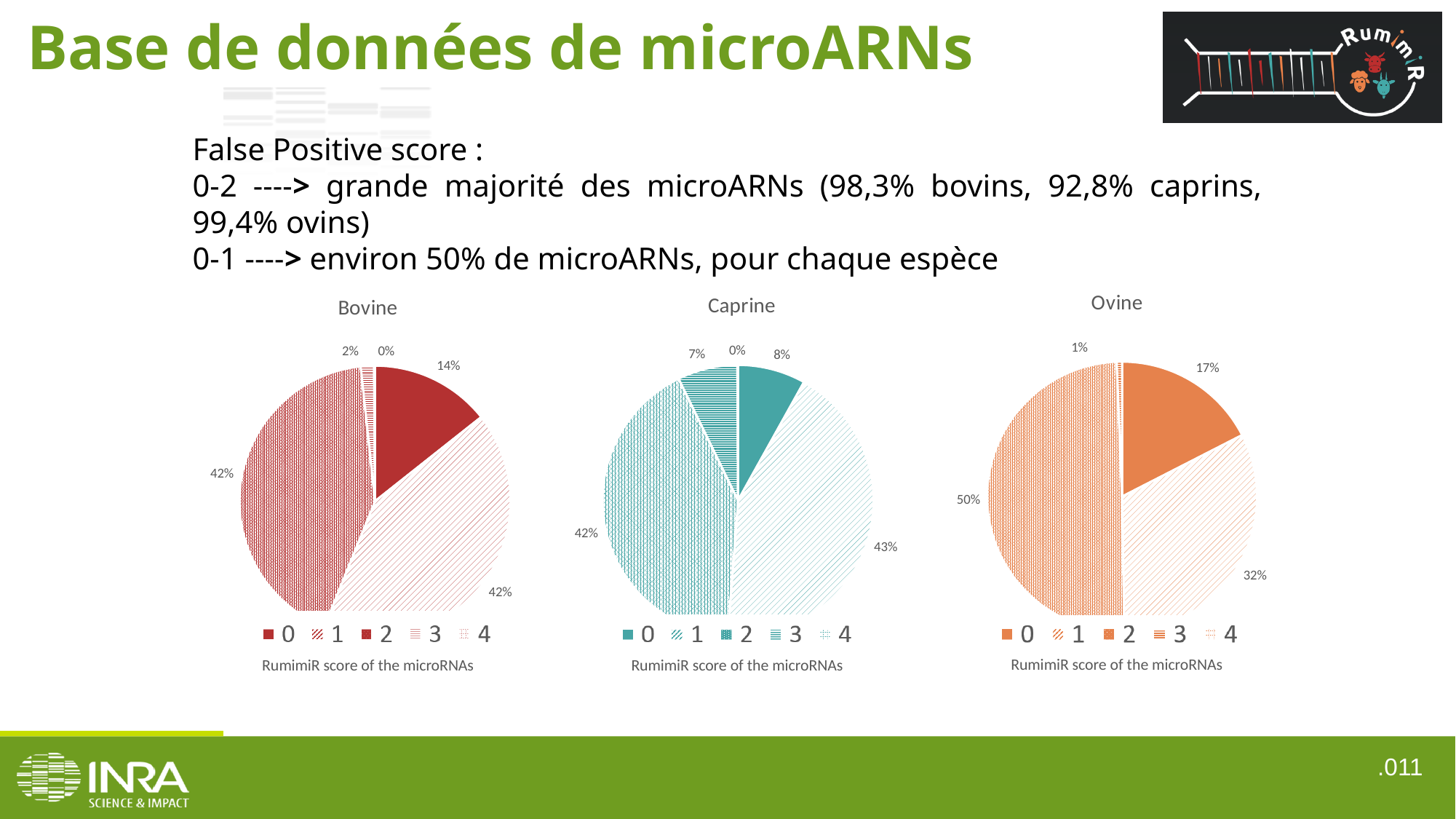
In the Bovine pie chart, what share of microRNAs has a RumimiR score of 0? 14% In the Bovine pie chart, which RumimiR score has the smallest share? 4 In the Caprine pie chart, what share of microRNAs has a RumimiR score of 1? 43% How many entries does the legend of the Bovine pie chart list? 5 What type of chart is used for the Caprine data? pie chart In the Caprine pie chart, which RumimiR score has the largest share? 1 In the Caprine pie chart, what share of microRNAs has a RumimiR score of 3? 7% In the Ovine pie chart, what is the difference between the shares for scores 2 and 1? 18% In the Caprine pie chart, which is larger: the share for score 0 or the share for score 3? score 0 In the Ovine pie chart, what share of microRNAs has a RumimiR score of 0? 17% In the Ovine pie chart, what share of microRNAs has a RumimiR score of 2? 50% In the Ovine pie chart, which RumimiR score has the largest share? 2